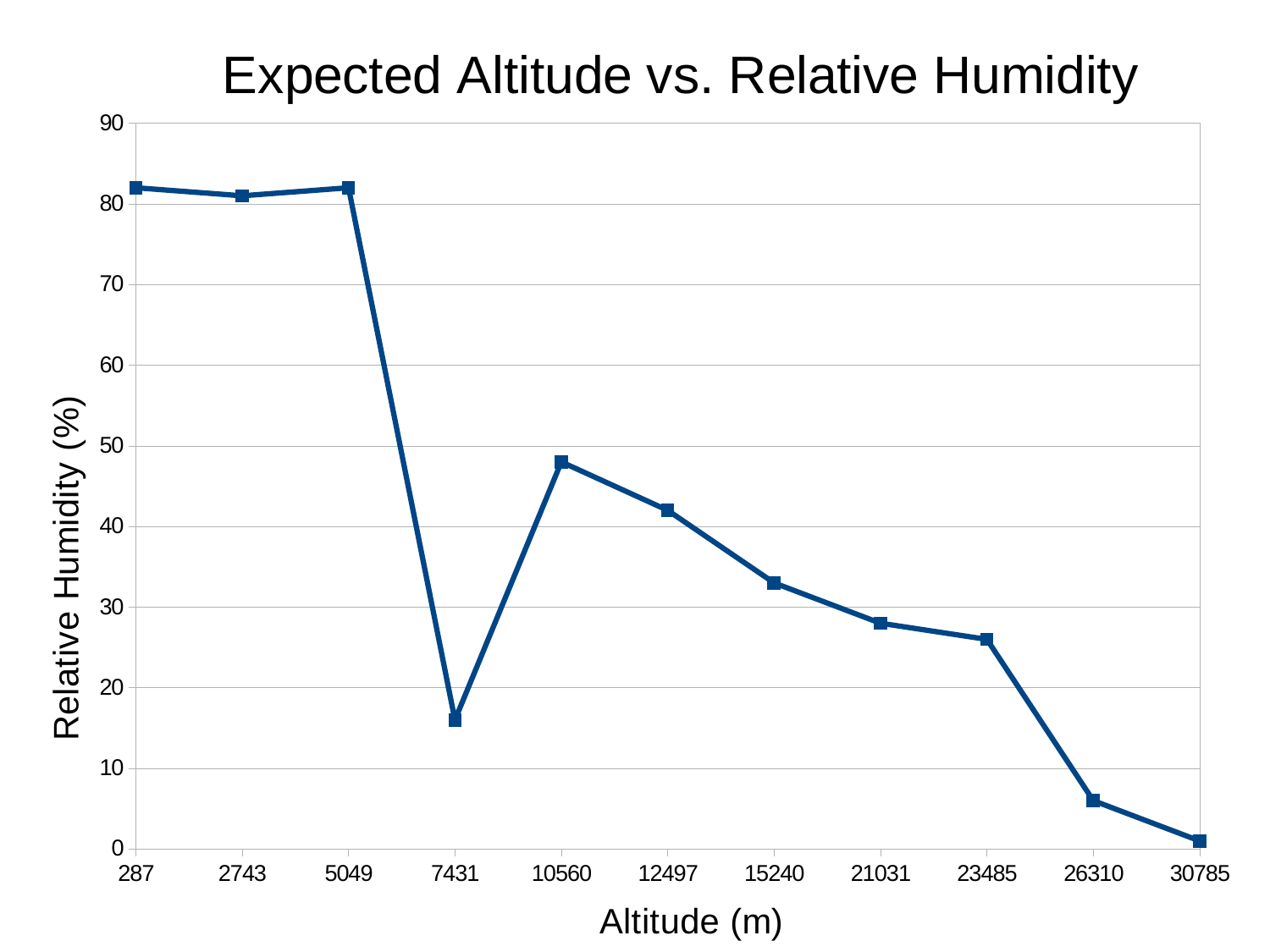
Is the relative humidity at 26310 m greater or less than 10? less What kind of chart is shown on the slide? line chart Overall, does relative humidity rise or fall as altitude increases along the x axis? fall Which altitude has the lowest relative humidity? 30785 How many altitude points are plotted on the chart? 11 What is the label of the y axis? Relative Humidity (%) Is the relative humidity at 287 m greater or less than 80? greater Is the relative humidity at 7431 m greater or less than 20? less What is the title of the chart? Expected Altitude vs. Relative Humidity Which has the higher relative humidity, 10560 m or 12497 m? 10560